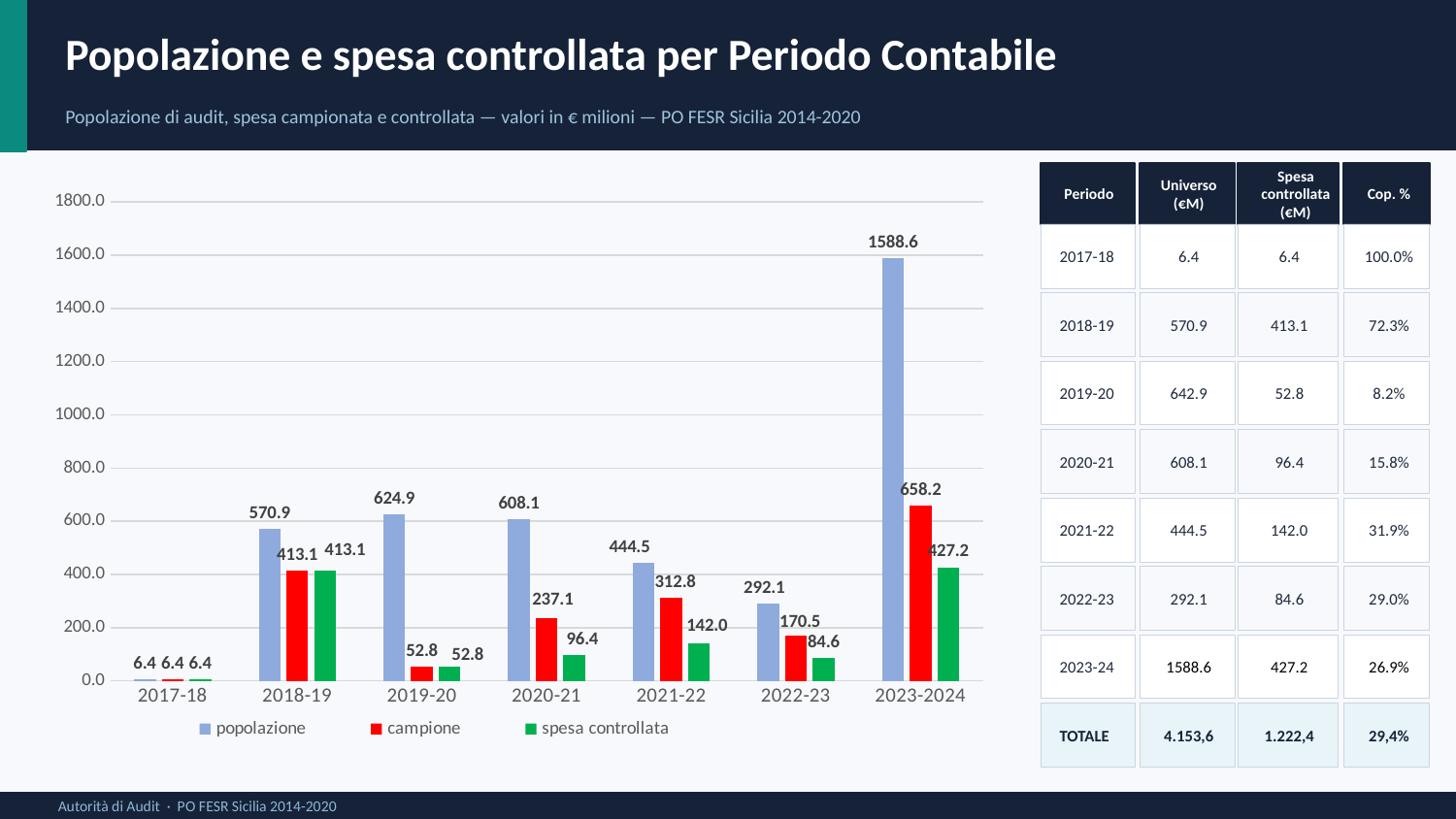
Which colour represents the spesa controllata series in the chart? green What is the difference between the popolazione and campione values for 2018-19? 157.8 What is the popolazione value for 2023-2024? 1588.6 What kind of chart is shown on the slide? bar chart Which period has the lowest spesa controllata value? 2017-18 Which period has the highest popolazione value? 2023-2024 Which is larger, the campione value for 2021-22 or the campione value for 2022-23? 2021-22 How many series does the chart legend list? 3 Is the popolazione value for 2019-20 greater or less than 600.0? greater How many periods are shown on the x axis of the chart? 7 What is the spesa controllata value for 2021-22? 142.0 What is the campione value for 2020-21? 237.1